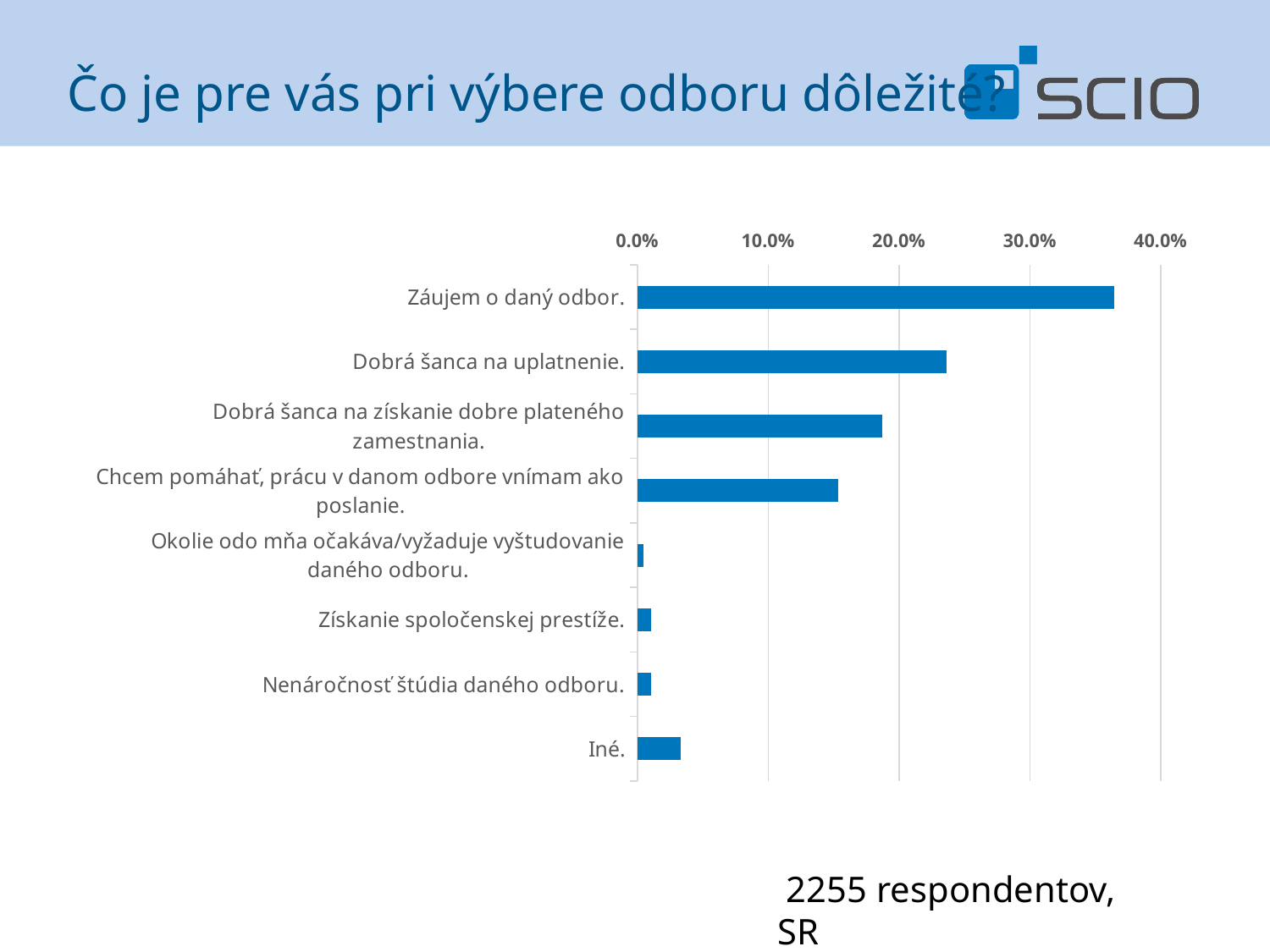
Is the value for "Dobrá šanca na získanie dobre plateného zamestnania." greater or less than 20.0%? less Which has a larger value: "Iné." or "Získanie spoločenskej prestíže."? Iné. Which category has the highest value in the chart? Záujem o daný odbor. Is the value for "Iné." greater or less than 10.0%? less Is the value for "Chcem pomáhať, prácu v danom odbore vnímam ako poslanie." greater or less than 10.0%? greater How many categories are plotted in the chart? 8 What kind of chart is shown on the slide? bar chart Which category has the lowest value in the chart? Okolie odo mňa očakáva/vyžaduje vyštudovanie daného odboru. What is the highest value shown on the chart's horizontal axis? 40.0% Which has a larger value: "Dobrá šanca na uplatnenie." or "Chcem pomáhať, prácu v danom odbore vnímam ako poslanie."? Dobrá šanca na uplatnenie.